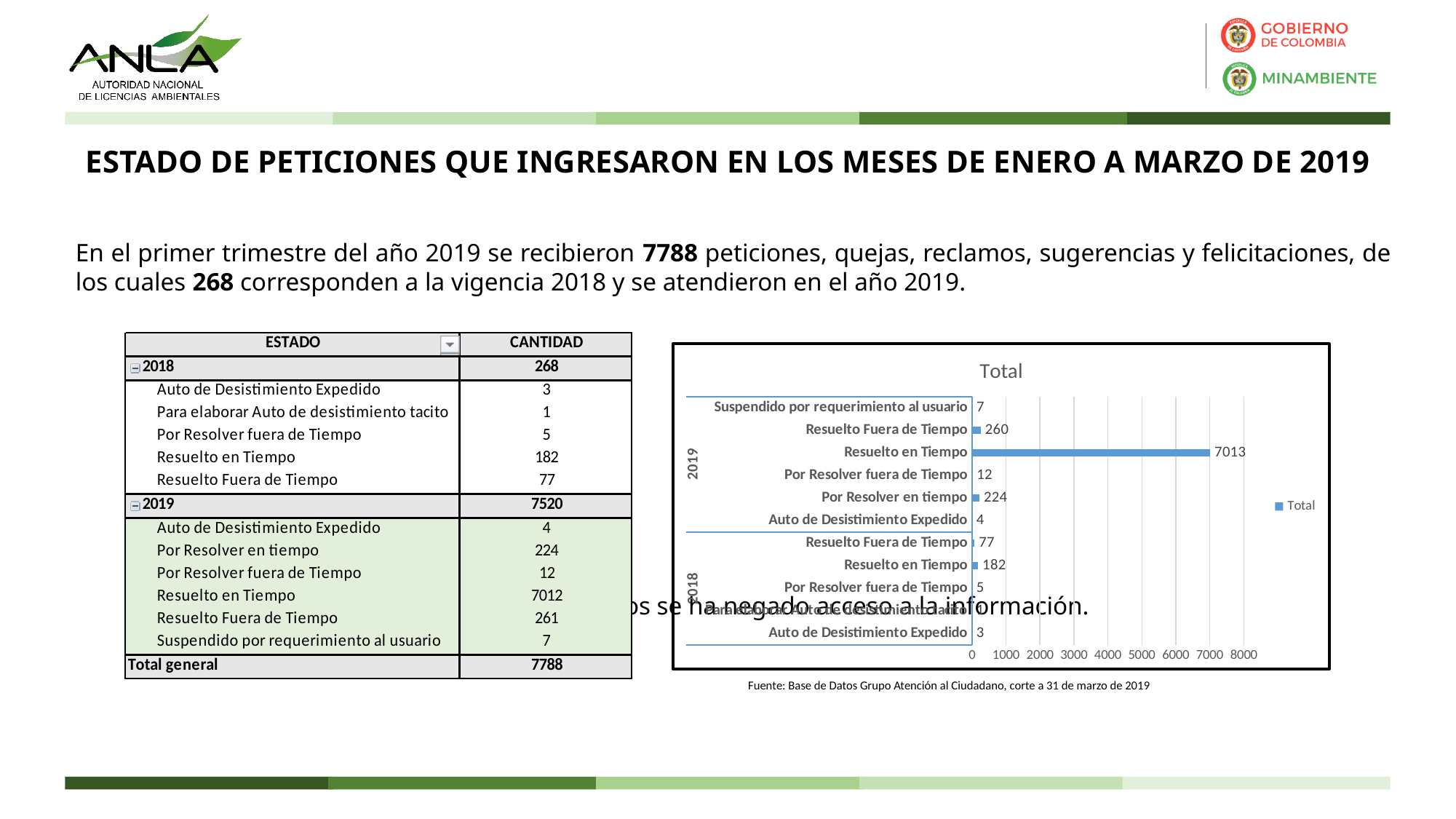
In the chart, which is larger: Resuelto Fuera de Tiempo in 2019 or Resuelto Fuera de Tiempo in 2018? Resuelto Fuera de Tiempo in 2019 In the chart, what is the value for Resuelto en Tiempo in 2018? 182 How many series does the chart legend list? 1 In the chart, what is the value for Resuelto en Tiempo in 2019? 7013 In the chart, what is the value for Suspendido por requerimiento al usuario in 2019? 7 In the chart, what is the value for Resuelto Fuera de Tiempo in 2019? 260 What kind of chart is shown on the slide? bar chart What is the title of the chart? Total In the chart, what is the value for Por Resolver en tiempo in 2019? 224 Which category has the highest value in the chart? Resuelto en Tiempo (2019) In the chart, what is the difference between Resuelto en Tiempo in 2019 and Resuelto en Tiempo in 2018? 6831 In the chart, is the value for Resuelto en Tiempo in 2019 greater or less than 6000? greater